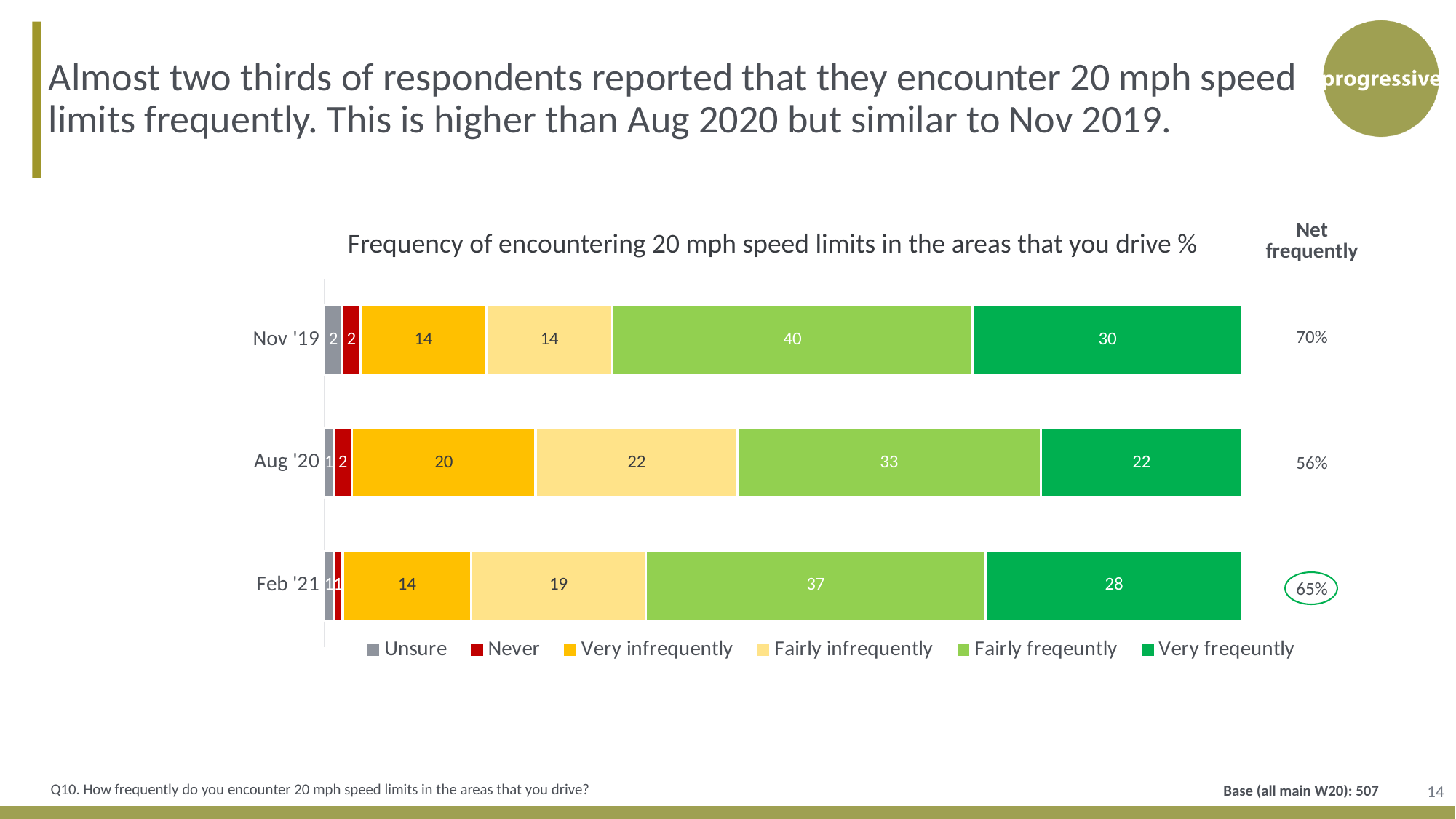
Which period has the highest value for Fairly infrequently? Aug '20 How many series does the legend list? 6 Which period has the lowest value for Very frequently? Aug '20 What is the difference between the Fairly frequently values for Nov '19 and Aug '20? 7 What is the value for Fairly frequently in Nov '19? 40 What is the total of the stacked bar for Aug '20? 100 Which is larger: the Fairly infrequently value for Feb '21 or the Very infrequently value for Feb '21? Fairly infrequently What kind of chart is shown on the slide? Stacked bar chart How many periods are shown on the chart? 3 What is the value for Very infrequently in Aug '20? 20 What is the Net frequently figure shown for Aug '20? 56% What is the value for Very frequently in Feb '21? 28